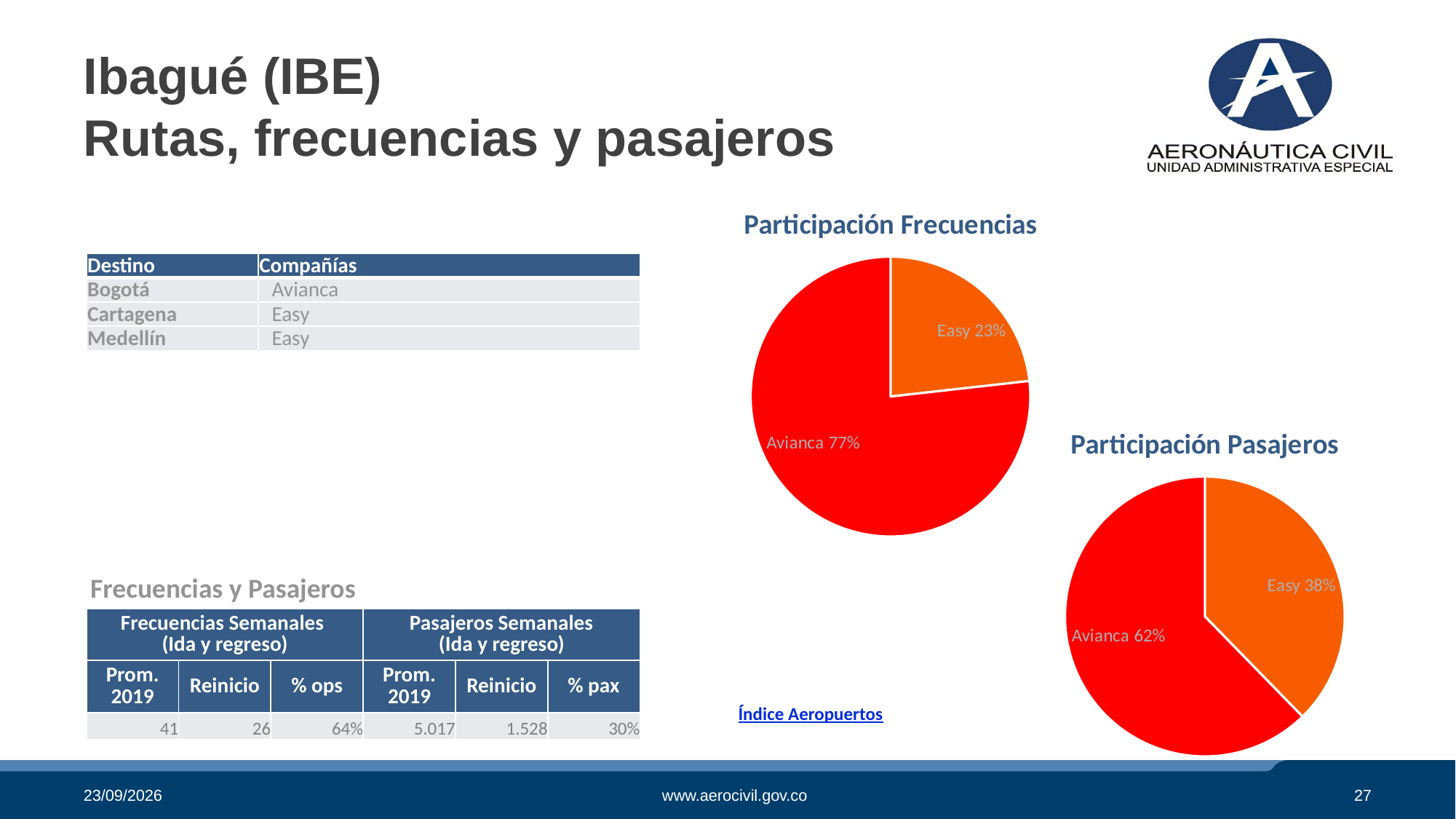
In the 'Participación Frecuencias' chart, what is the difference in percentage points between Avianca's and Easy's shares? 54 In the 'Participación Pasajeros' chart, what is the difference in percentage points between Avianca's and Easy's shares? 24 What kind of chart is 'Participación Pasajeros'? Pie chart In the 'Participación Pasajeros' chart, which airline has the smallest slice? Easy In the 'Participación Pasajeros' chart, what share does Avianca have? 62% In the 'Participación Frecuencias' chart, what share does Easy have? 23% In the 'Participación Frecuencias' chart, what share does Avianca have? 77% In the 'Participación Frecuencias' chart, which airline has the largest slice? Avianca Is Easy's share larger in the 'Participación Frecuencias' chart or in the 'Participación Pasajeros' chart? Participación Pasajeros How many slices does the 'Participación Frecuencias' pie chart have? 2 In the 'Participación Frecuencias' chart, what colour is the Avianca slice? Red